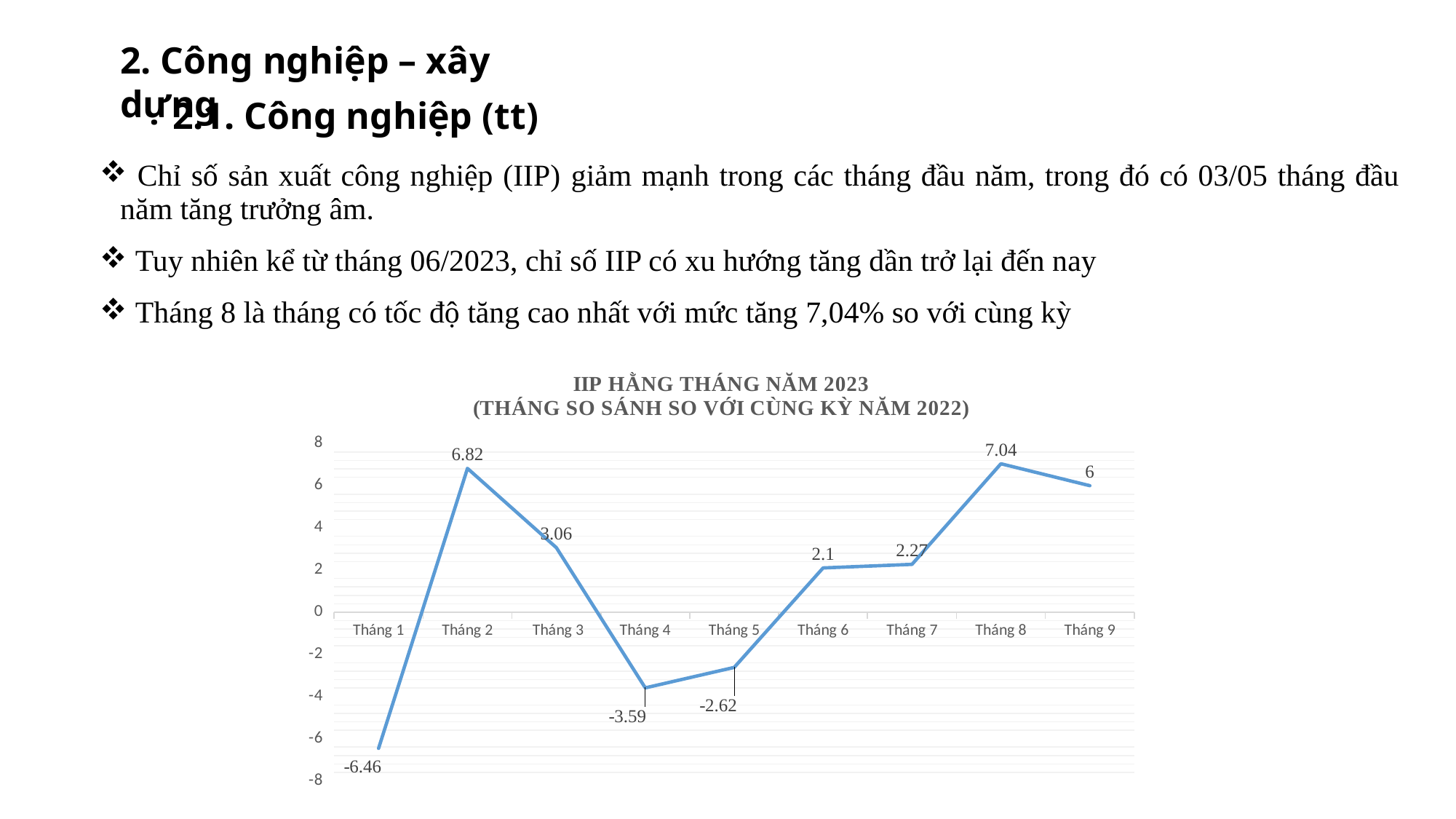
Which month has the lowest value? Tháng 1 What is the difference between the values for Tháng 8 and Tháng 2? 0.22 Which month has the highest value? Tháng 8 Is the value for Tháng 4 greater or less than -2? less What is the value for Tháng 1? -6.46 What is the value for Tháng 9? 6 What is the value for Tháng 5? -2.62 Do the values rise or fall from Tháng 5 to Tháng 8? Rise What is the value for Tháng 8? 7.04 How many months are plotted on the chart? 9 Which is larger, the value for Tháng 3 or the value for Tháng 7? Tháng 3 What kind of chart is shown on the slide? Line chart